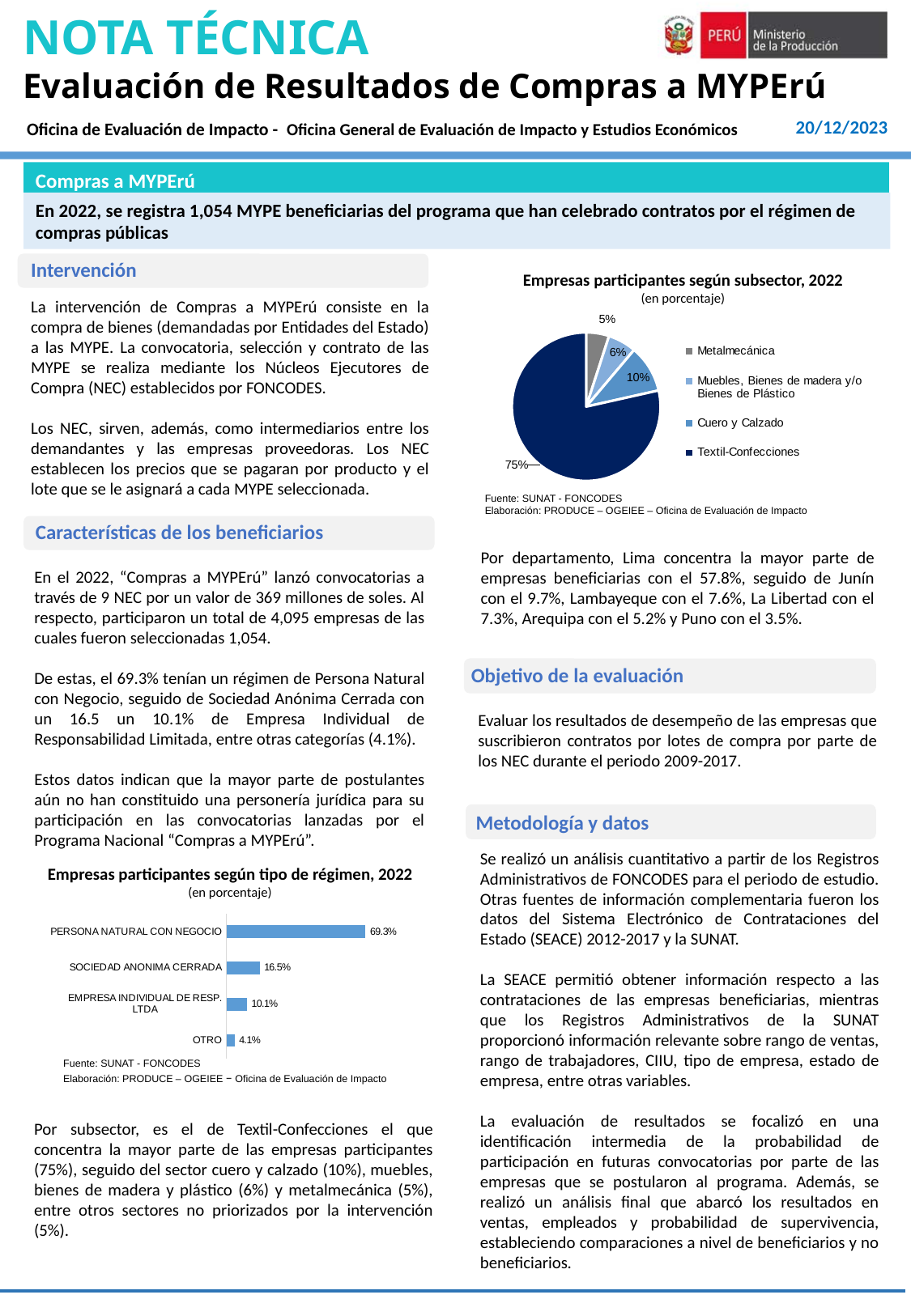
In the chart 'Empresas participantes según subsector, 2022', how many subsectors does the legend list? 4 In the chart 'Empresas participantes según tipo de régimen, 2022', what is the difference between PERSONA NATURAL CON NEGOCIO and EMPRESA INDIVIDUAL DE RESP. LTDA? 59.2 percentage points In the chart 'Empresas participantes según subsector, 2022', what share does Cuero y Calzado have? 10% In the chart 'Empresas participantes según tipo de régimen, 2022', which category has the highest value? PERSONA NATURAL CON NEGOCIO What kind of chart is 'Empresas participantes según tipo de régimen, 2022'? Bar chart What kind of chart is 'Empresas participantes según subsector, 2022'? Pie chart In the chart 'Empresas participantes según tipo de régimen, 2022', what is the value for OTRO? 4.1% In the chart 'Empresas participantes según tipo de régimen, 2022', which is larger: SOCIEDAD ANONIMA CERRADA or EMPRESA INDIVIDUAL DE RESP. LTDA? SOCIEDAD ANONIMA CERRADA In the chart 'Empresas participantes según tipo de régimen, 2022', what is the value for SOCIEDAD ANONIMA CERRADA? 16.5% In the chart 'Empresas participantes según subsector, 2022', what share does Textil-Confecciones have? 75% In the chart 'Empresas participantes según subsector, 2022', which subsector has the smallest share? Metalmecánica In the chart 'Empresas participantes según subsector, 2022', what is the difference between the shares of Cuero y Calzado and Metalmecánica? 5 percentage points